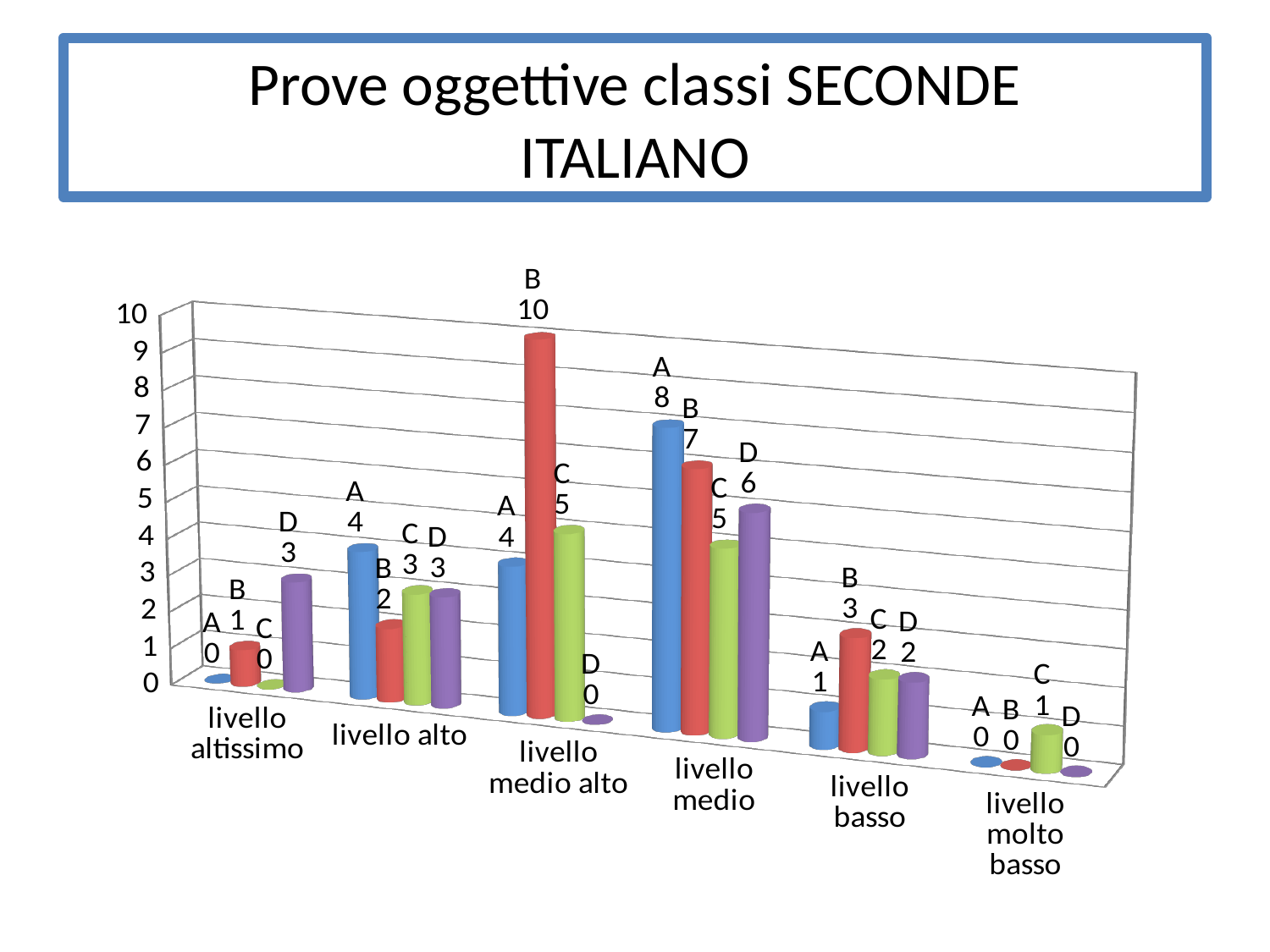
What kind of chart is shown on the slide? bar chart What is the title of the slide? Prove oggettive classi SECONDE ITALIANO What is the value for series A at livello medio? 8 Which category has the highest value for series B? livello medio alto What is the difference between series A and series D at livello medio? 2 What is the value for series B at livello medio alto? 10 Which category has the highest value for series A? livello medio What is the value for series C at livello molto basso? 1 Which is larger at livello alto: series A or series B? series A What is the difference between series B and series A at livello medio alto? 6 How many categories are shown on the x axis? 6 What is the value for series D at livello altissimo? 3